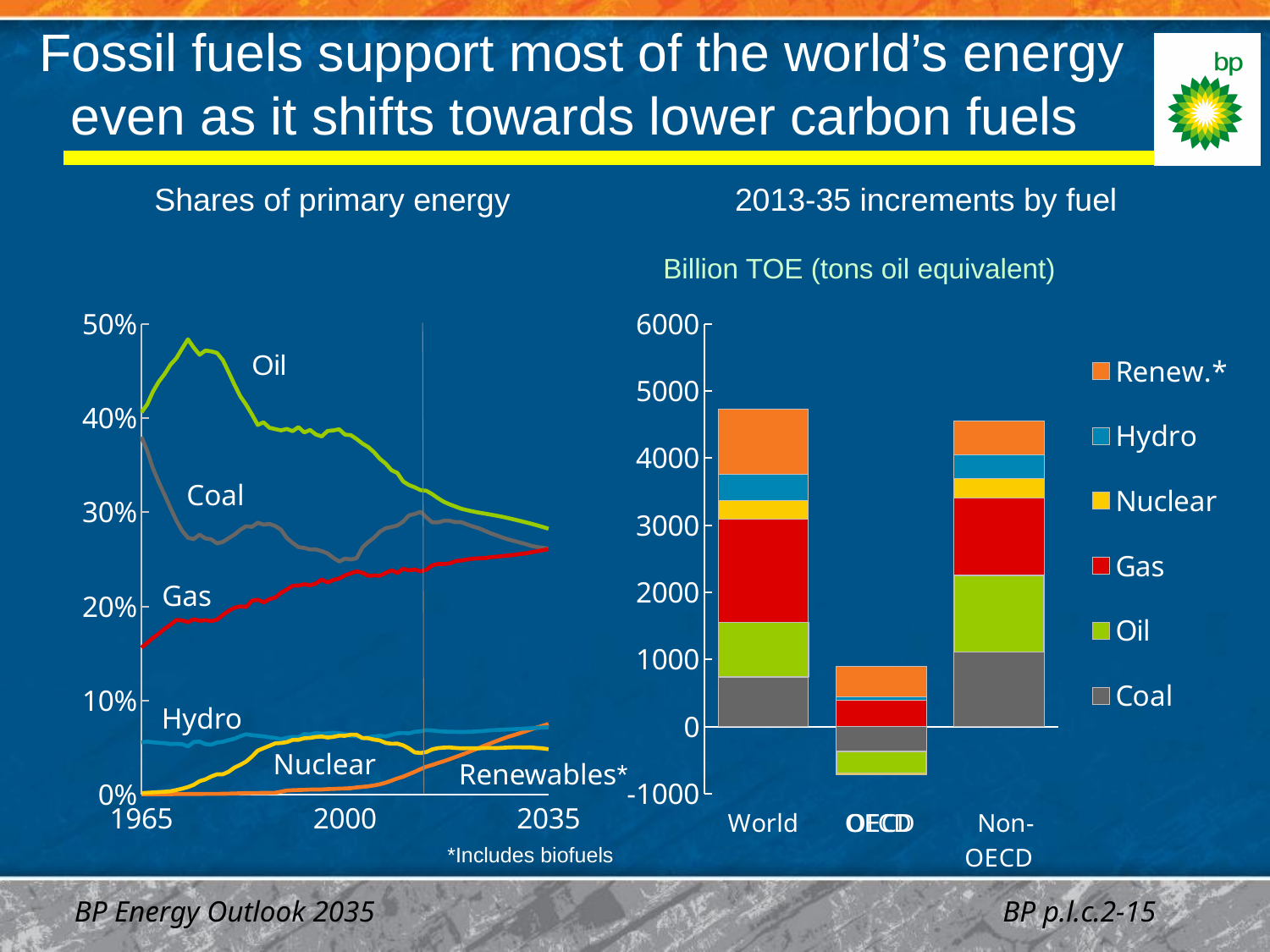
In the '2013-35 increments by fuel' chart, how many categories are shown on the x axis? 3 What kind of chart is the 'Shares of primary energy' chart on the left? line chart In the 'Shares of primary energy' chart, is the share of Hydro in 2035 greater or less than 10%? less In the '2013-35 increments by fuel' chart, how many series does the legend list? 6 In the 'Shares of primary energy' chart, does the share of Gas rise or fall from 1965 to 2035? rise In the 'Shares of primary energy' chart, is the share of Oil in 2035 greater or less than 20%? greater In the '2013-35 increments by fuel' chart, is the top of the World bar greater or less than 4000? greater What kind of chart is the '2013-35 increments by fuel' chart on the right? stacked bar chart In the 'Shares of primary energy' chart, does the share of Oil rise or fall between 2000 and 2035? fall In the '2013-35 increments by fuel' chart, which category has the smallest total increment? OECD In the 'Shares of primary energy' chart, how many fuel series are plotted? 6 In the 'Shares of primary energy' chart, which fuel has the highest share throughout the period shown? Oil